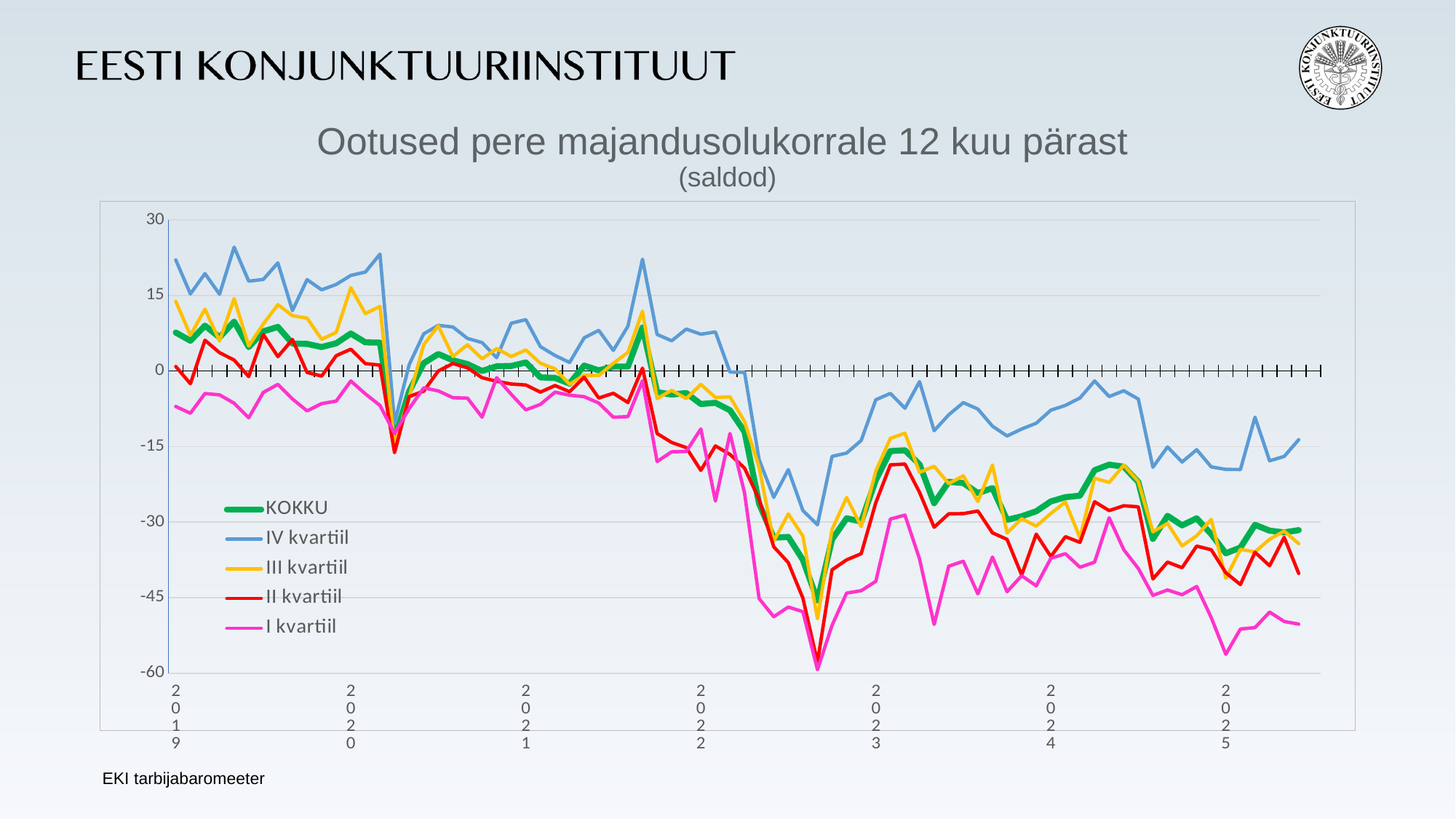
What kind of chart is shown on the slide? line chart Is the value for I kvartiil at the start of 2019 greater or less than 0? less Do the values for KOKKU rise or fall from 2019 to 2025 overall? fall Is the value for IV kvartiil at the start of 2019 greater or less than 15? greater Which series is drawn in pink? I kvartiil Which series has the highest values across most of the chart? IV kvartiil Is the lowest value reached by I kvartiil greater or less than -45? less Which series has the lowest values across most of the chart? I kvartiil What is the title of the chart? Ootused pere majandusolukorrale 12 kuu pärast At the start of 2019, which is larger, IV kvartiil or I kvartiil? IV kvartiil How many series does the legend list? 5 How many year labels are shown on the x axis? 7